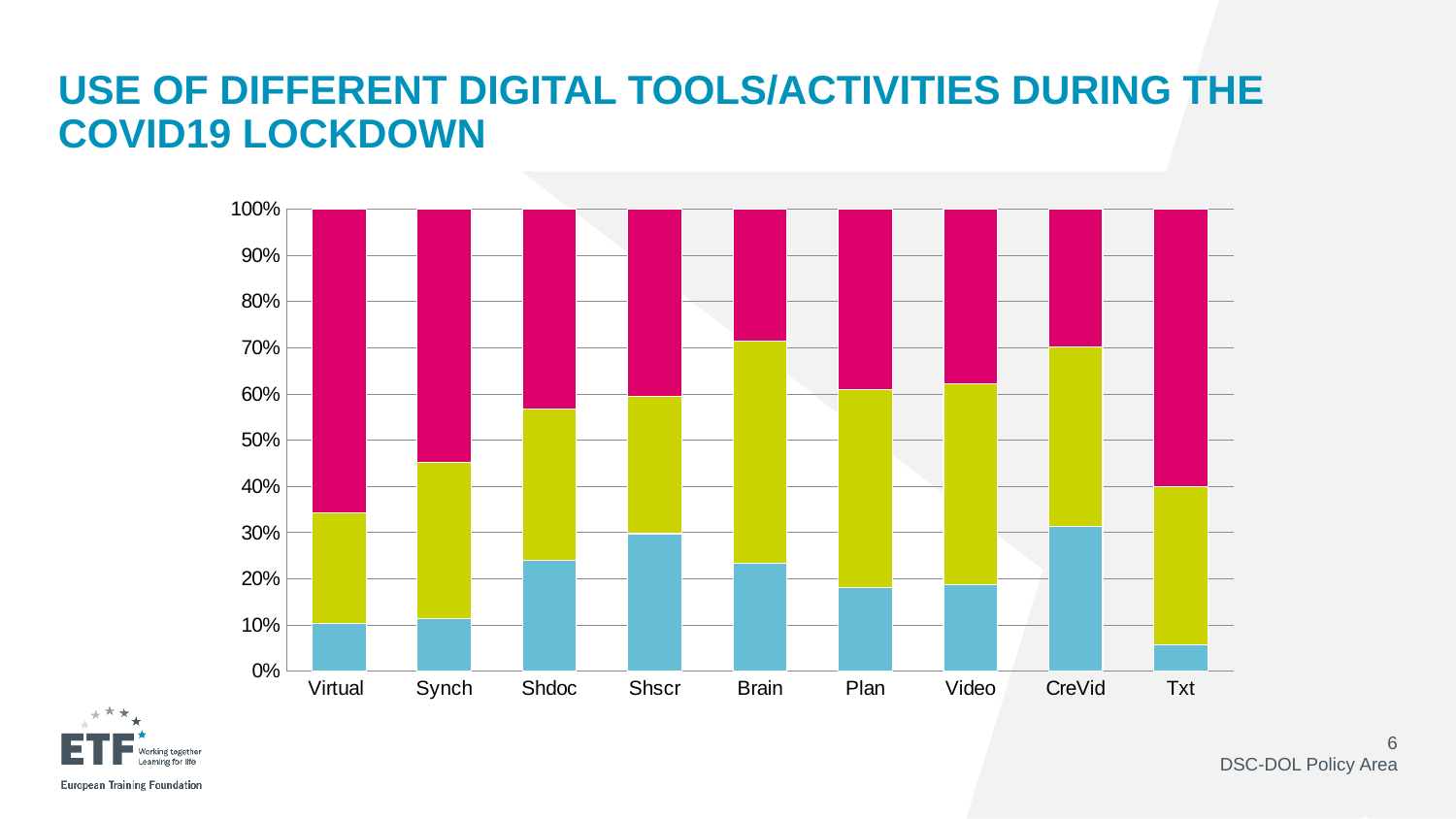
Which has the larger blue (bottom) segment, Shdoc or Synch? Shdoc Which has the larger blue (bottom) segment, CreVid or Txt? CreVid How many categories are shown along the x axis of the chart? 9 Which category has the smallest blue (bottom) segment? Txt Is the blue (bottom) segment for Synch greater or less than 20%? less What kind of chart is shown on the slide? stacked bar chart What is the total height of the stacked bar for Virtual? 100% Is the blue (bottom) segment for Shscr greater or less than 20%? greater Is the blue (bottom) segment for Txt greater or less than 10%? less What is the title of the slide containing the chart? USE OF DIFFERENT DIGITAL TOOLS/ACTIVITIES DURING THE COVID19 LOCKDOWN Which category has the largest magenta (top) segment? Virtual How many coloured segments make up each stacked bar in the chart? 3